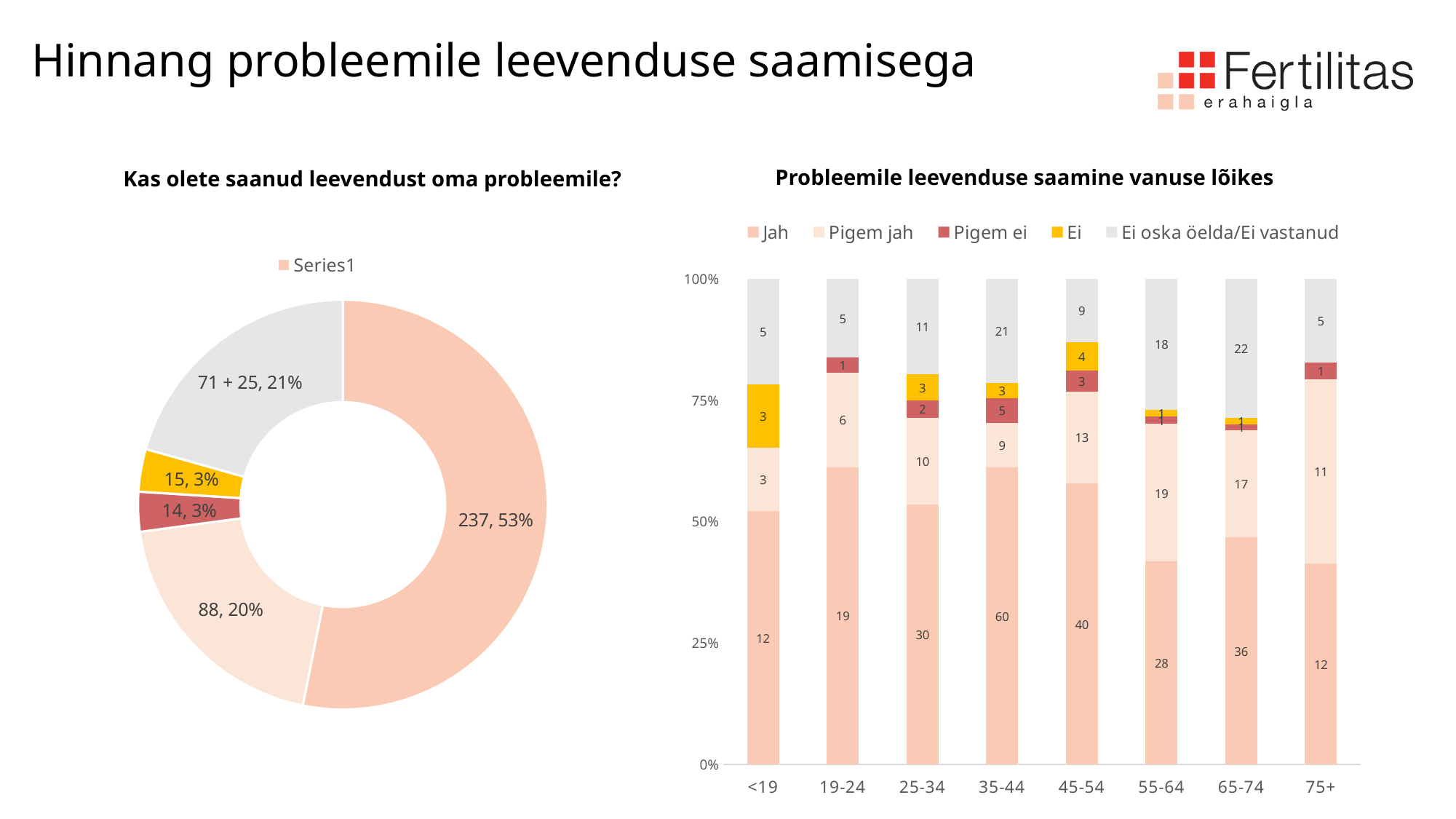
In the chart "Probleemile leevenduse saamine vanuse lõikes", what is the "Ei oska öelda/Ei vastanud" value for the 65-74 age group? 22 What kind of chart is the chart titled "Probleemile leevenduse saamine vanuse lõikes"? Stacked bar chart How many series does the legend of the chart "Probleemile leevenduse saamine vanuse lõikes" list? 5 In the chart "Probleemile leevenduse saamine vanuse lõikes", what is the "Pigem jah" value for the 25-34 age group? 10 In the chart "Probleemile leevenduse saamine vanuse lõikes", is the "Jah" share of the 65-74 bar greater or less than 50%? less In the chart "Probleemile leevenduse saamine vanuse lõikes", what is the difference between the "Jah" values for the 45-54 and 55-64 age groups? 12 In the chart "Probleemile leevenduse saamine vanuse lõikes", what is the "Jah" value for the 35-44 age group? 60 In the chart "Probleemile leevenduse saamine vanuse lõikes", which age group has the larger "Pigem jah" value, 55-64 or 65-74? 55-64 How many age groups are shown on the x axis of the chart "Probleemile leevenduse saamine vanuse lõikes"? 8 In the chart "Kas olete saanud leevendust oma probleemile?", what percentage share does the largest slice have? 53% What kind of chart is the chart titled "Kas olete saanud leevendust oma probleemile?"? Donut (pie) chart In the chart "Probleemile leevenduse saamine vanuse lõikes", which age group has the highest "Jah" value? 35-44